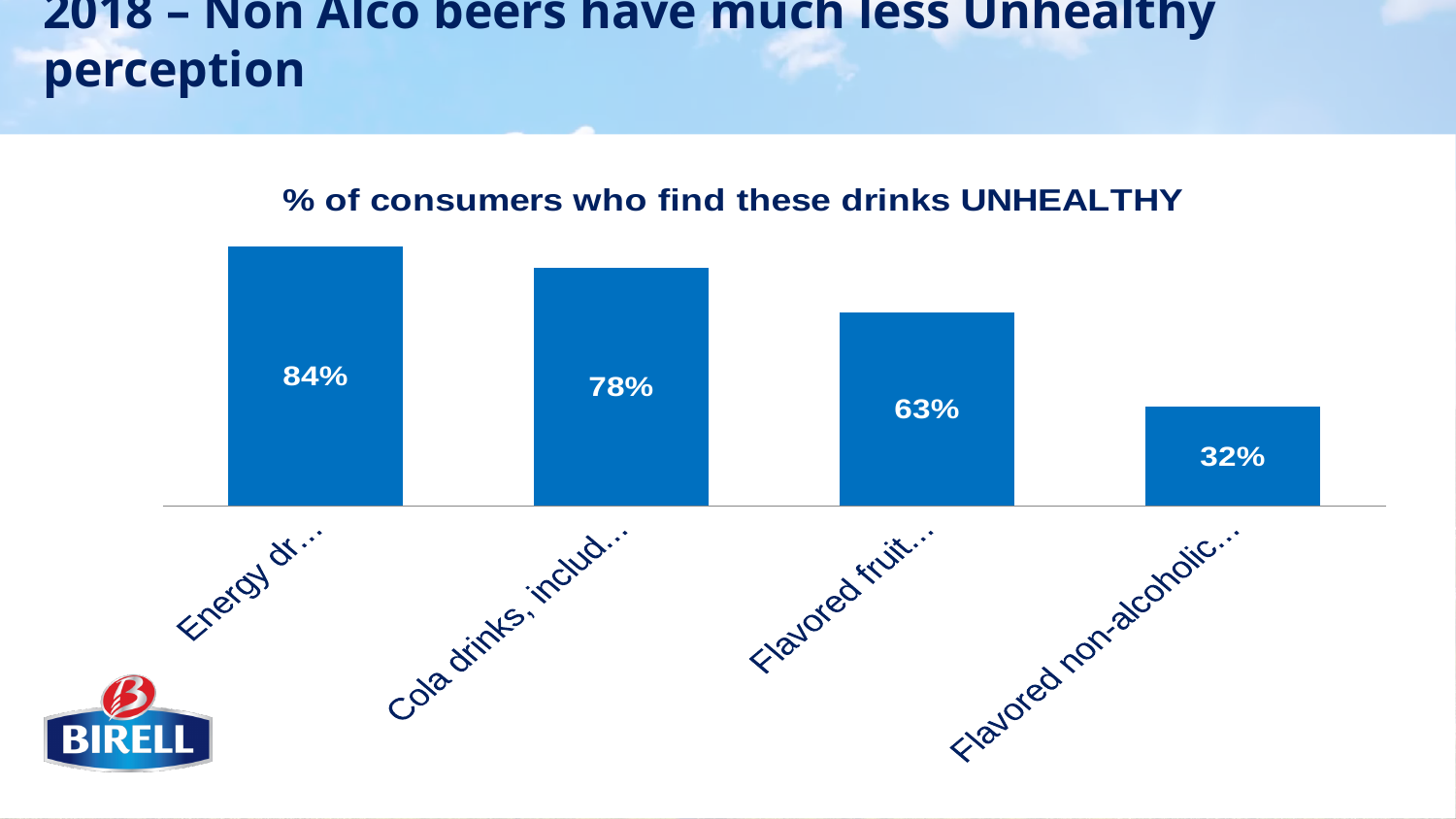
What value is shown for the bar labelled "Cola drinks, includ…"? 78% Which category has the highest percentage of consumers finding it unhealthy? Energy dr… What is the title of the chart? % of consumers who find these drinks UNHEALTHY Which category has the lowest percentage of consumers finding it unhealthy? Flavored non-alcoholic… What is the difference between the values for "Cola drinks, includ…" and "Flavored fruit…"? 15% What value is shown for the first bar, labelled "Energy dr…"? 84% What kind of chart is shown on the slide? Bar chart Which is larger, the value for "Flavored fruit…" or the value for "Flavored non-alcoholic…"? Flavored fruit… What is the difference between the values for "Energy dr…" and "Flavored non-alcoholic…"? 52% What value is shown for the bar labelled "Flavored non-alcoholic…"? 32% How many categories are plotted in the chart? 4 What value is shown for the bar labelled "Flavored fruit…"? 63%